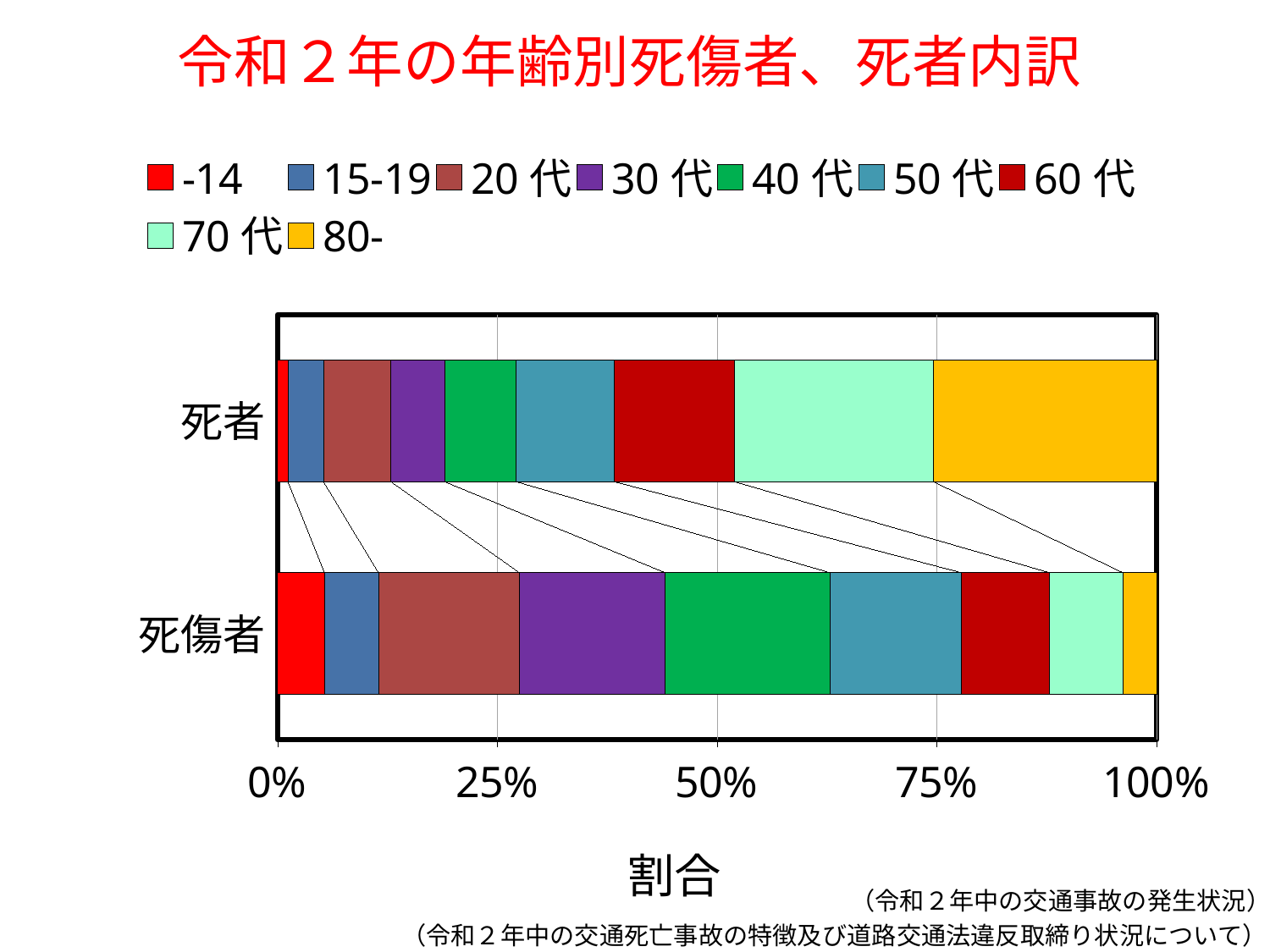
How many bars (categories) does the chart show? 2 Which age group takes the largest share of the 死者 bar? 80- How many series does the legend list? 9 Is the share of the -14 age group larger in the 死者 bar or the 死傷者 bar? 死傷者 What is the label of the horizontal axis? 割合 Is the share of the 40 代 age group larger in the 死者 bar or the 死傷者 bar? 死傷者 Which age group takes the smallest share of the 死者 bar? -14 What is the title of the chart? 令和２年の年齢別死傷者、死者内訳 Is the share of the 80- age group larger in the 死者 bar or the 死傷者 bar? 死者 What is the highest value shown on the horizontal axis? 100% What kind of chart is shown on the slide? stacked bar chart Which age group takes the smallest share of the 死傷者 bar? 80-